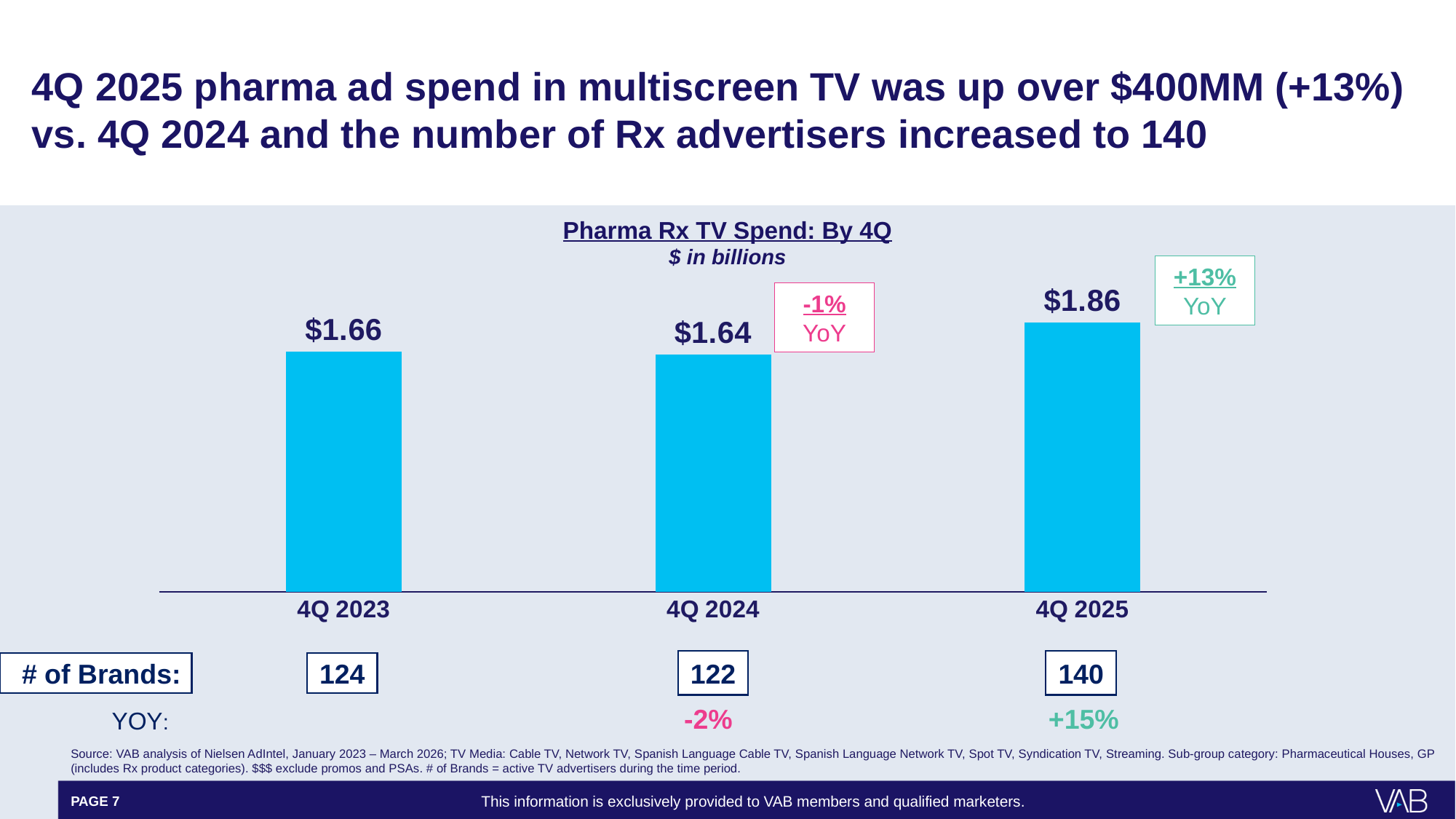
What is the Pharma Rx TV spend for 4Q 2023? $1.66 How many quarters are shown in the chart? 3 What is the Pharma Rx TV spend for 4Q 2025? $1.86 Which quarter has the highest Pharma Rx TV spend? 4Q 2025 Which quarter has the lowest Pharma Rx TV spend? 4Q 2024 What kind of chart is shown on the slide? bar chart Is the spend for 4Q 2023 larger or smaller than the spend for 4Q 2025? smaller What is the YOY change in number of brands shown for 4Q 2025? +15% What is the number of brands shown for 4Q 2024? 122 What is the difference in spend between 4Q 2025 and 4Q 2024? $0.22 What is the YoY change in spend shown for 4Q 2025? +13% What is the title of the chart? Pharma Rx TV Spend: By 4Q